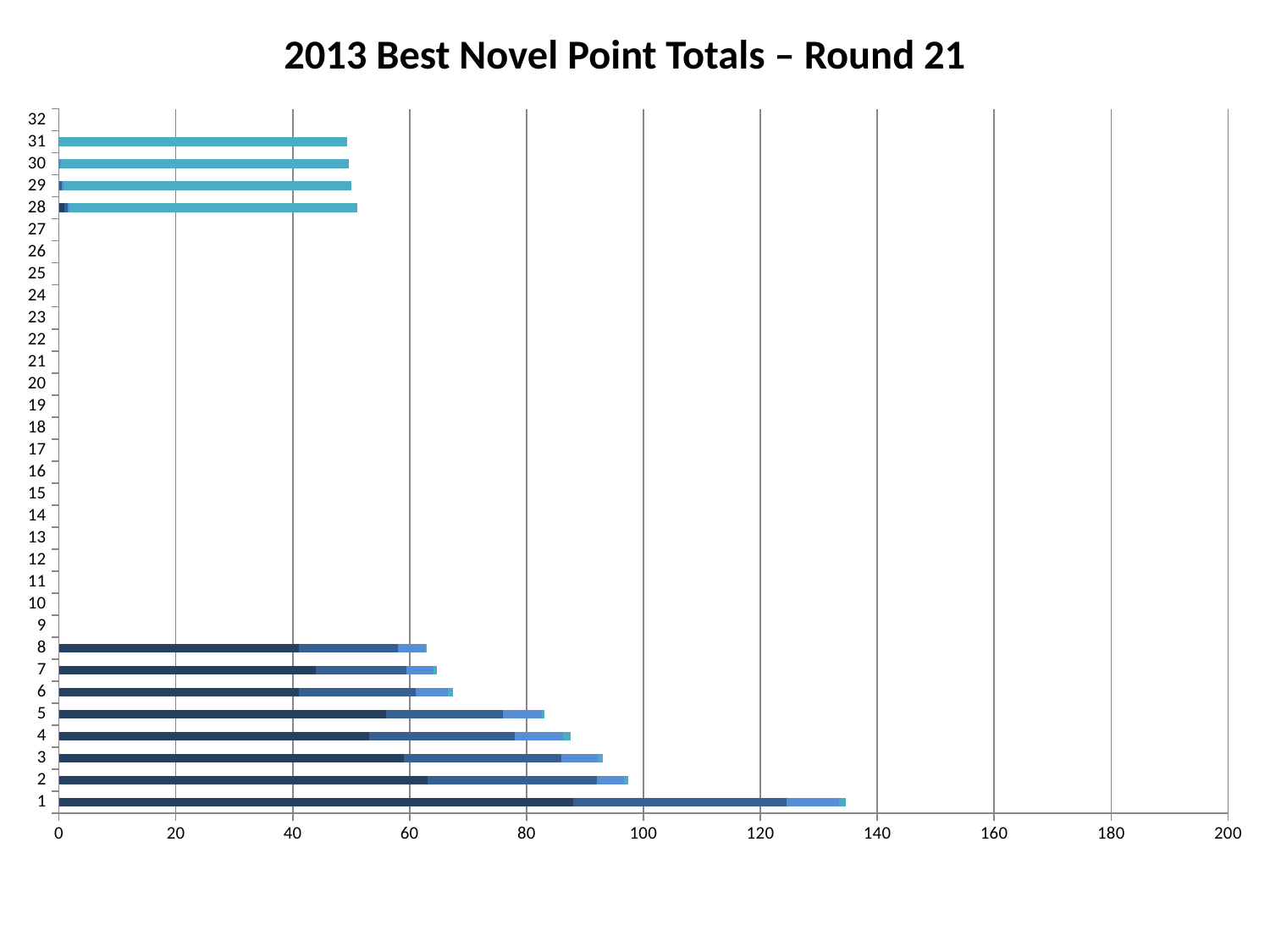
How many categories are labelled on the vertical axis? 32 Is the total value for category 5 greater or less than 80? greater Is the total value for category 1 greater or less than 120? greater What is the highest value shown on the horizontal axis? 200 Is the total value for category 8 greater or less than 60? greater What is the title of the chart? 2013 Best Novel Point Totals – Round 21 Which has the larger total, category 8 or category 28? 8 Which has the larger total, category 2 or category 5? 2 What kind of chart is shown on the slide? bar chart Which category has the longest bar in the chart? 1